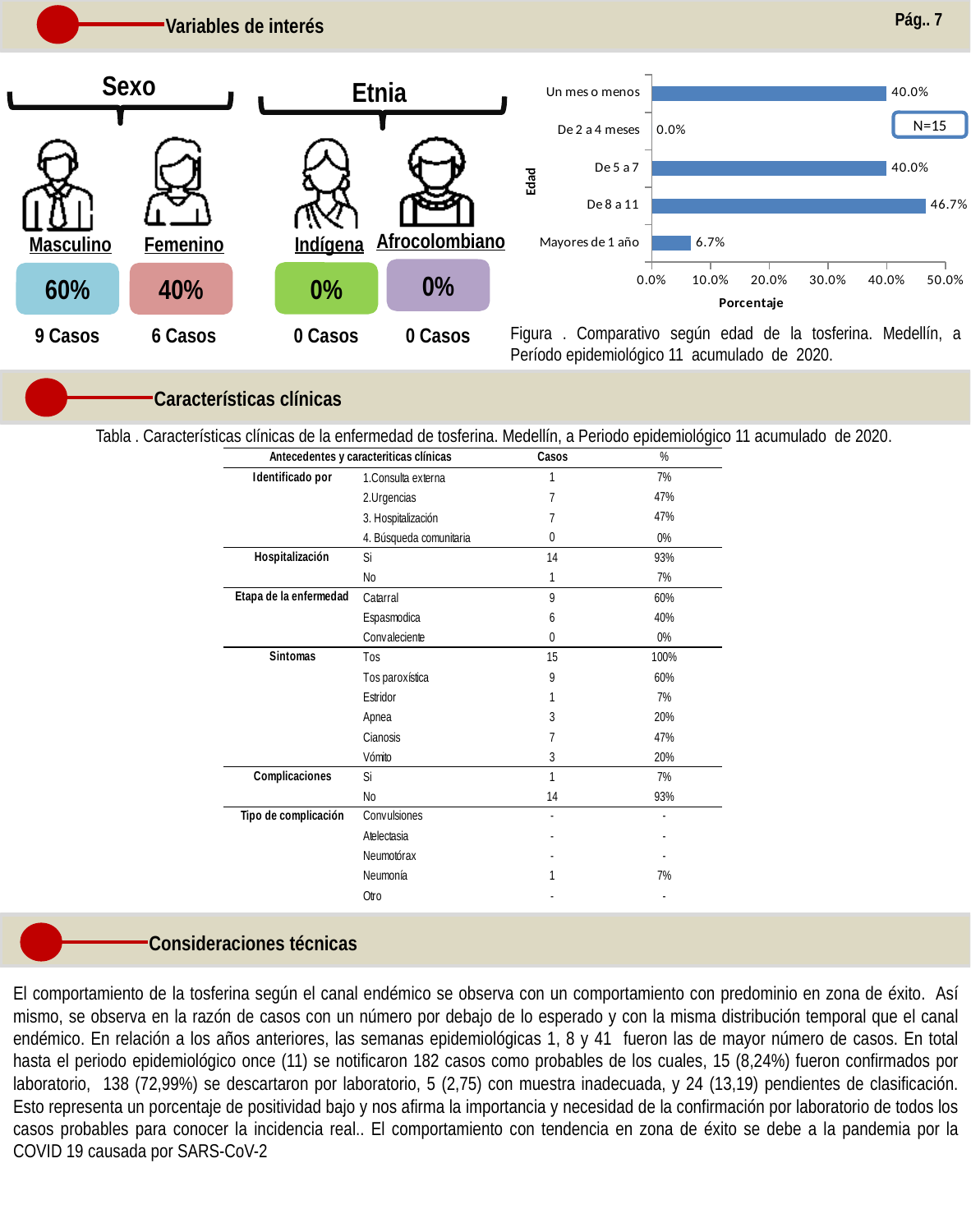
What is the value for 'Un mes o menos' in the bar chart? 40.0% How many age categories are shown in the bar chart? 5 What is the value for 'De 2 a 4 meses' in the bar chart? 0.0% Which age group has the highest value in the bar chart? De 8 a 11 What type of chart is used to show the age comparison? Bar chart What is the label of the horizontal axis of the bar chart? Porcentaje What is the value for 'De 8 a 11' in the bar chart? 46.7% What is the difference between the values for 'De 8 a 11' and 'Mayores de 1 año' in the bar chart? 40.0% Which age group has the lowest value in the bar chart? De 2 a 4 meses What is the value for 'Mayores de 1 año' in the bar chart? 6.7% What sample size (N) is shown in the box on the bar chart? N=15 Which is larger in the bar chart: the value for 'De 5 a 7' or the value for 'Mayores de 1 año'? De 5 a 7